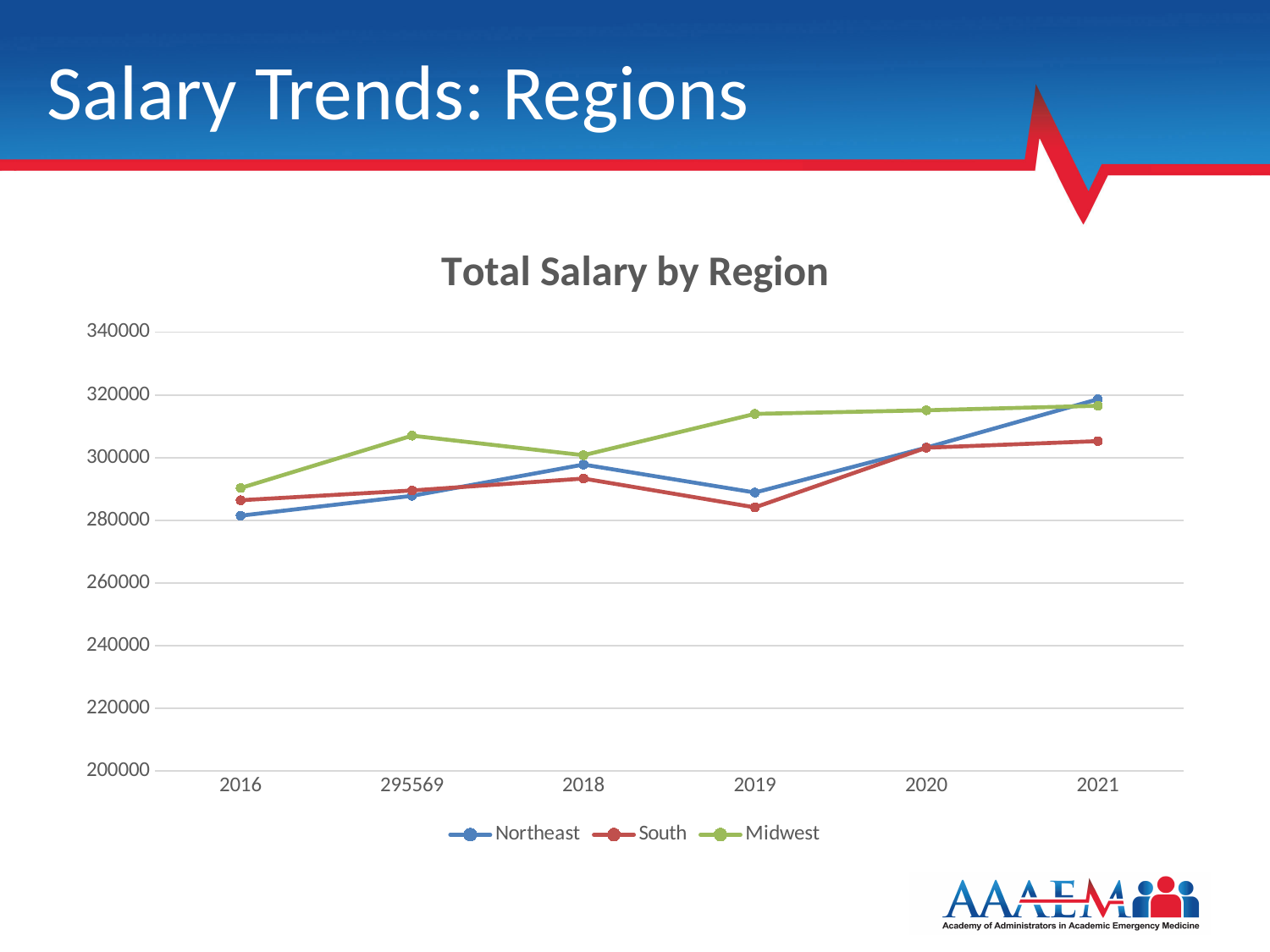
Which series is drawn in green in the Total Salary by Region chart? Midwest Which region has the lowest value in 2019? South How many series does the legend list in the Total Salary by Region chart? 3 Is the value for South in 2021 greater or less than 300000? greater Is the value for Midwest in 2016 greater or less than 280000? greater Is the value for Midwest in 2019 greater or less than 300000? greater What is the title of the chart? Total Salary by Region What kind of chart is shown on the slide? line chart In 2021, which is larger, the value for Northeast or the value for South? Northeast How many points along the x axis does each line in the Total Salary by Region chart have? 6 Which region has the highest value in 2019? Midwest